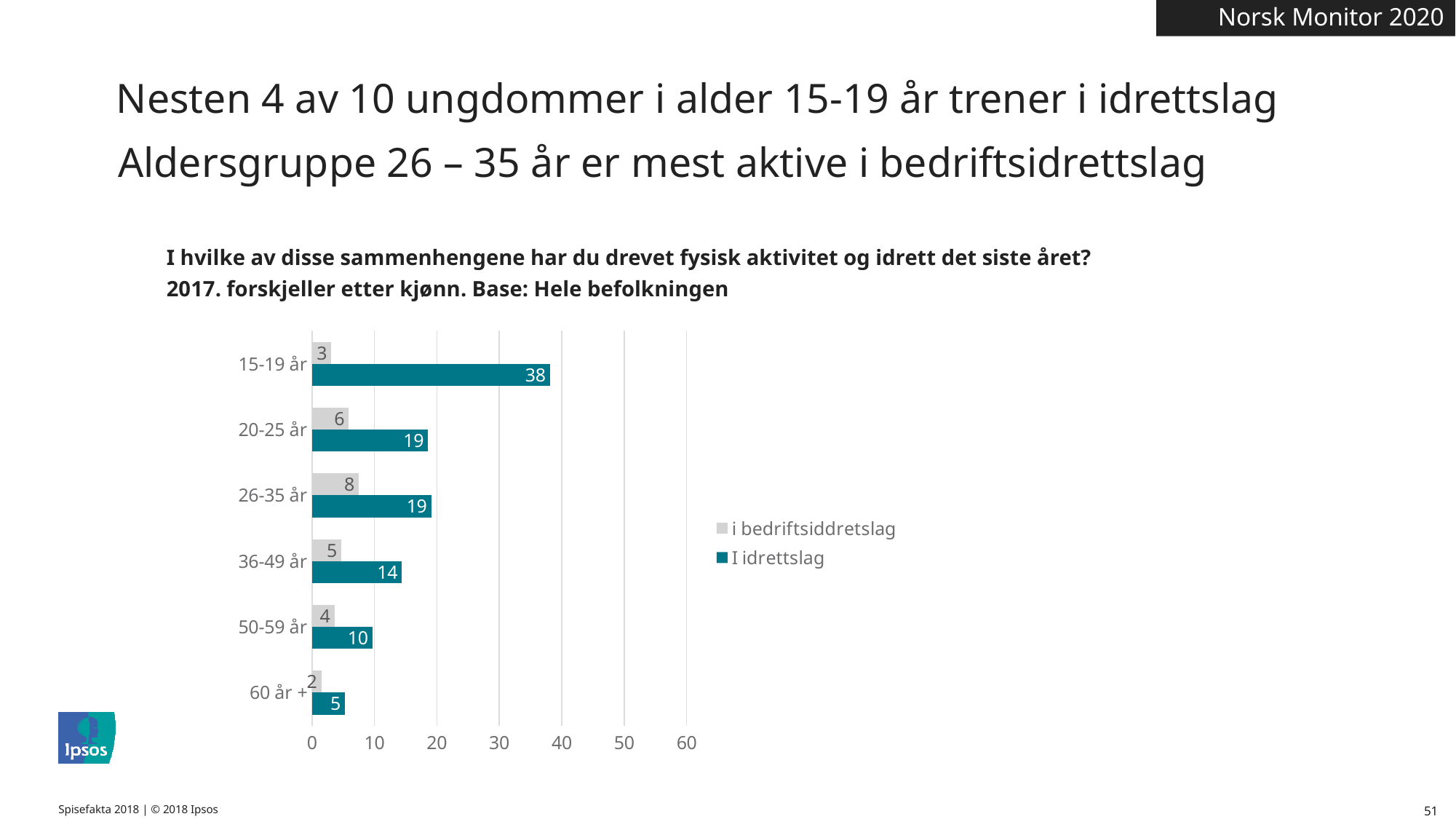
Is the 'I idrettslag' value for 15-19 år greater or less than 30? greater Which age group has the highest value for 'I idrettslag'? 15-19 år How many series does the legend list? 2 Which age group has the lowest value for 'i bedriftsiddretslag'? 60 år + Which is larger: the 'I idrettslag' value for 36-49 år or for 50-59 år? 36-49 år Which series is shown in teal on the chart? I idrettslag What is the difference between the 'I idrettslag' values for 15-19 år and 20-25 år? 19 What is the value for 'I idrettslag' in the 15-19 år age group? 38 What is the value for 'i bedriftsiddretslag' in the 26-35 år age group? 8 What is the value for 'I idrettslag' in the 50-59 år age group? 10 How many age groups are shown on the chart? 6 What kind of chart is shown on the slide? Bar chart